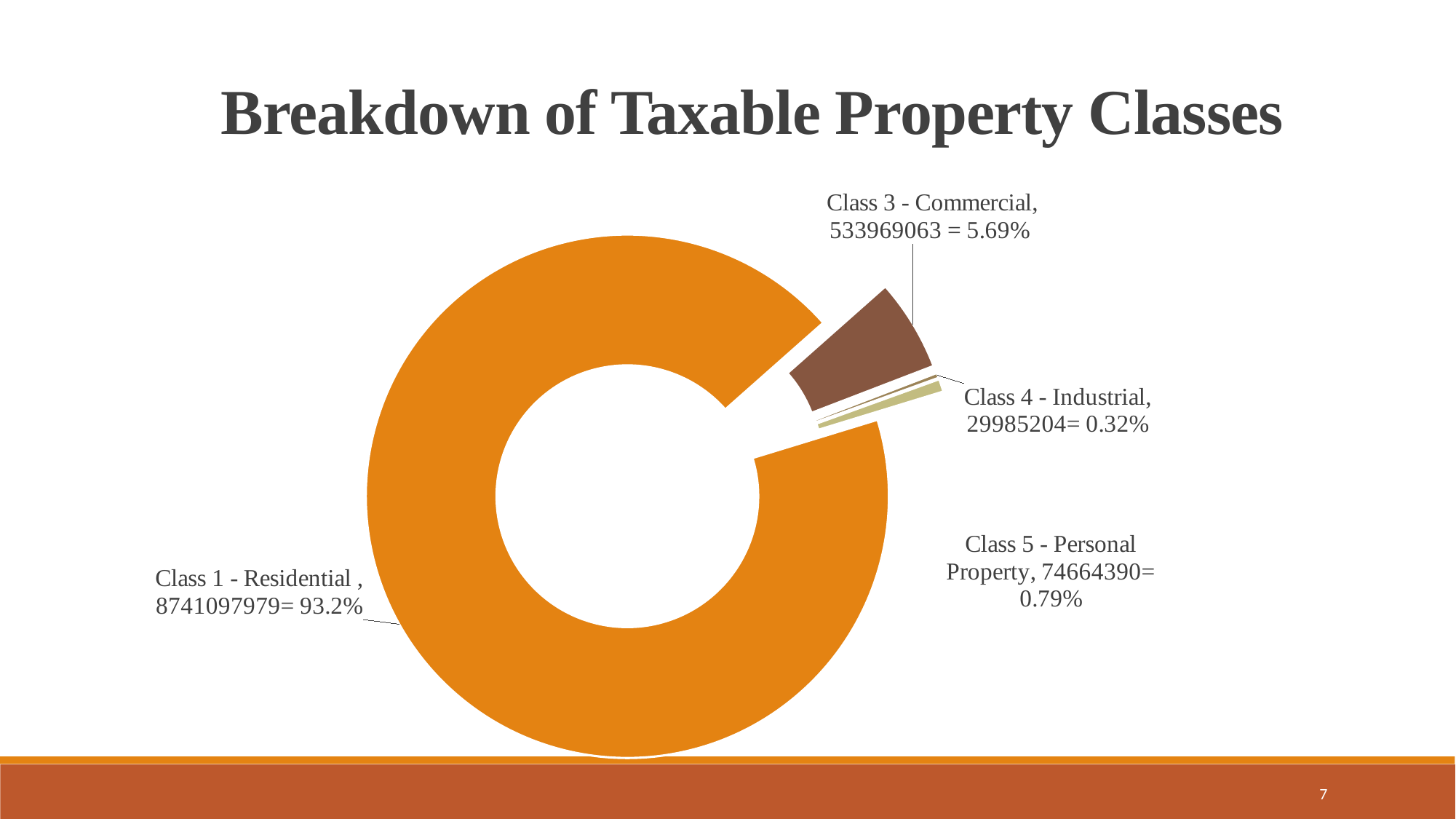
What share of the chart does Class 4 - Industrial represent? 0.32% What share of the chart does Class 5 - Personal Property represent? 0.79% What share of the chart does Class 1 - Residential represent? 93.2% Which property class has the largest share of the chart? Class 1 - Residential What is the title of the chart on the slide? Breakdown of Taxable Property Classes Which property class has the smallest share of the chart? Class 4 - Industrial What is the value shown for Class 1 - Residential? 8741097979 Which has a larger share, Class 5 - Personal Property or Class 4 - Industrial? Class 5 - Personal Property How many property classes are shown in the chart? 4 What kind of chart is shown on the slide? doughnut chart What is the value shown for Class 3 - Commercial? 533969063